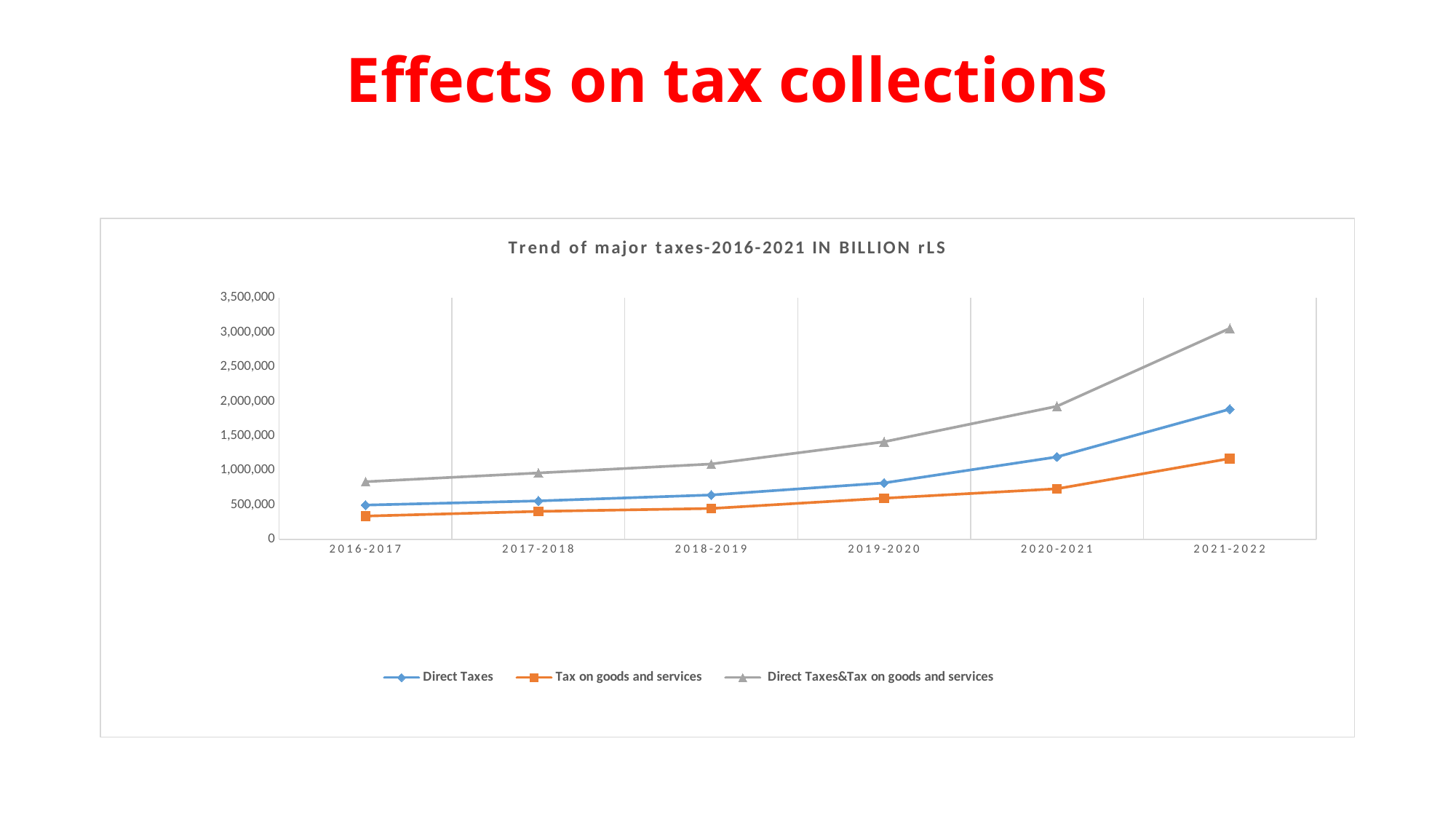
What kind of chart is shown on the slide? Line chart How many fiscal years are plotted along the x axis? 6 Is the value for Direct Taxes in 2021-2022 greater or less than 2,000,000? less Which series is drawn with the grey line and triangle markers? Direct Taxes&Tax on goods and services Is the value for Tax on goods and services in 2016-2017 greater or less than 500,000? less In which year is the value for Tax on goods and services lowest? 2016-2017 In 2021-2022, which is larger: Direct Taxes or Tax on goods and services? Direct Taxes In which year is the value for Direct Taxes&Tax on goods and services highest? 2021-2022 What is the title of the chart? Trend of major taxes-2016-2021 IN BILLION rLS Is the value for Direct Taxes&Tax on goods and services in 2021-2022 greater or less than 2,500,000? greater Do the values for Direct Taxes rise or fall from 2016-2017 to 2021-2022? Rise How many series does the legend list? 3